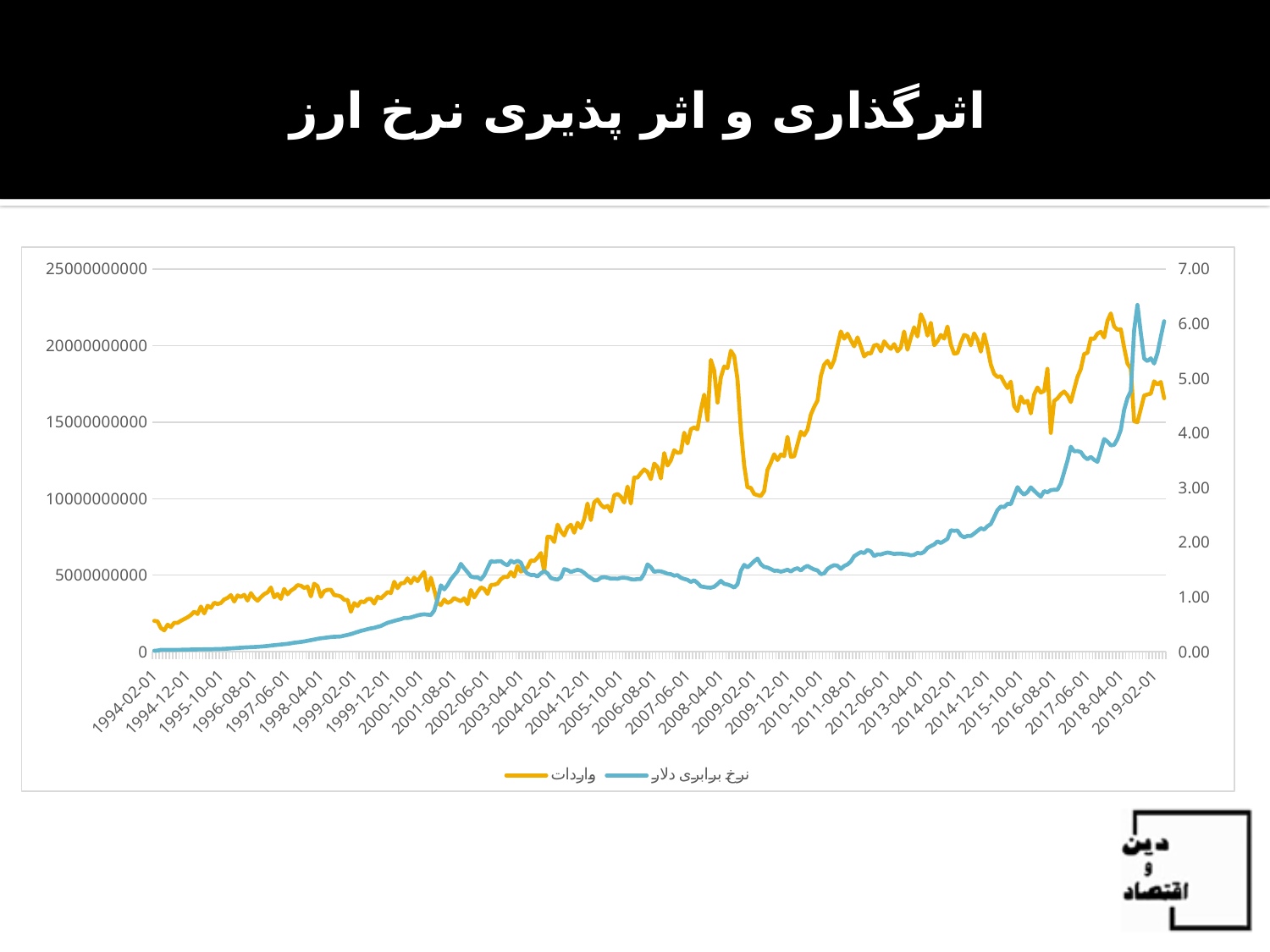
What colour is the واردات line? yellow Does the واردات line rise or fall between 2008-04-01 and 2009-02-01? fall Is the value for واردات at 1994-02-01 greater or less than 5000000000? less How many series does the legend list? 2 Is the value for نرخ برابری دلار at 1996-08-01 greater or less than 1.00? less Is the value for نرخ برابری دلار at 2019-02-01 greater or less than 5.00? greater Does the نرخ برابری دلار line generally rise or fall from 1994-02-01 to 2019-02-01? rise What kind of chart is shown on the slide? line chart What are the two series named in the legend? واردات and نرخ برابری دلار